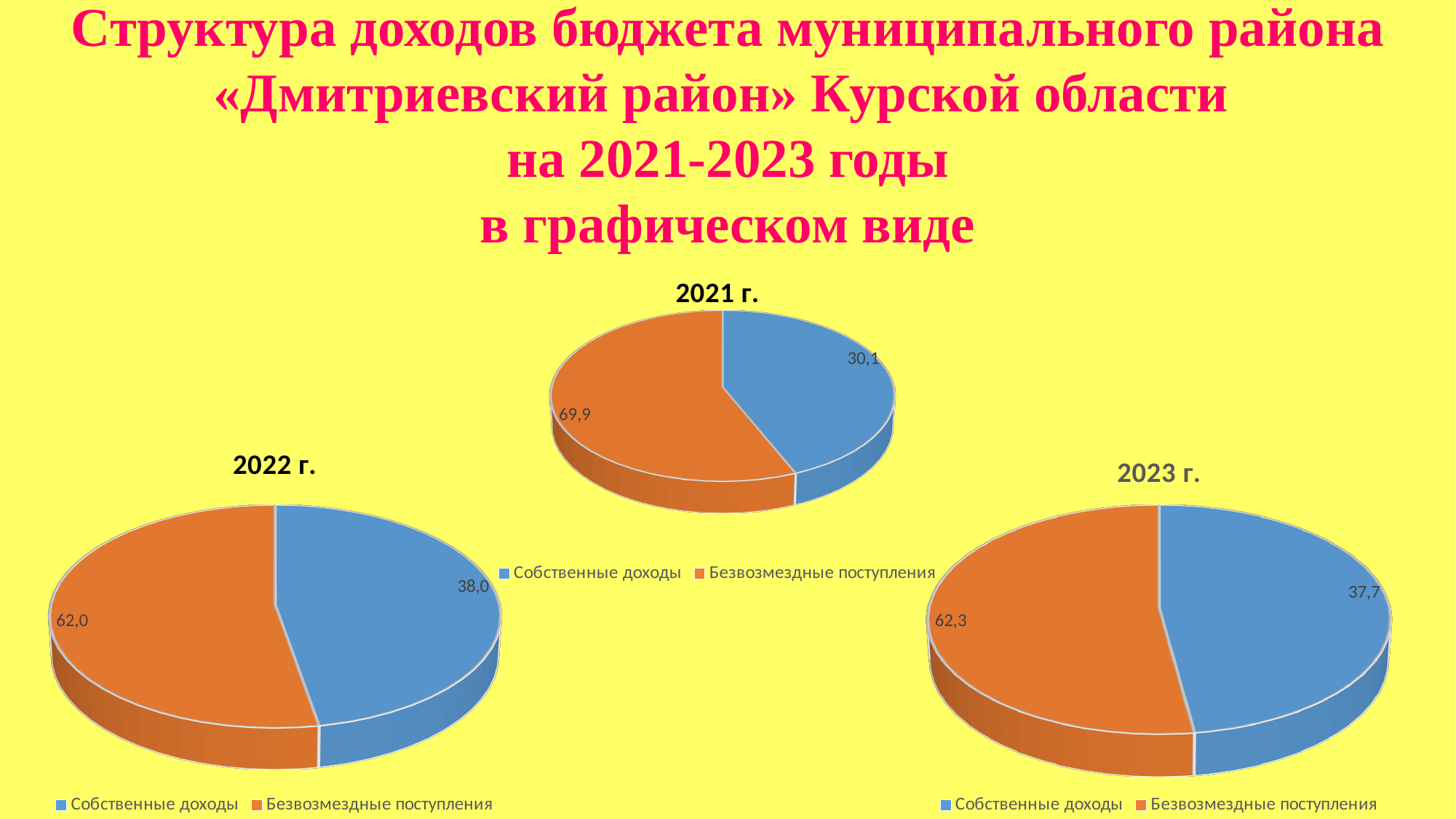
How many slices does the chart titled "2023 г." have? 2 In the chart titled "2021 г.", what is the difference between Безвозмездные поступления and Собственные доходы? 39,8 In the chart titled "2022 г.", what is the difference between Безвозмездные поступления and Собственные доходы? 24,0 What kind of chart is the chart titled "2021 г."? Pie chart In the chart titled "2022 г.", what colour is the slice for Собственные доходы? Blue In the chart titled "2023 г.", which category has the smallest slice? Собственные доходы Which is larger: Собственные доходы in the chart titled "2022 г." or Собственные доходы in the chart titled "2023 г."? 2022 г. In the chart titled "2022 г.", what is the value for Собственные доходы? 38,0 In the chart titled "2021 г.", what is the value for Собственные доходы? 30,1 In the chart titled "2021 г.", what is the value for Безвозмездные поступления? 69,9 In the chart titled "2023 г.", what is the value for Безвозмездные поступления? 62,3 In the chart titled "2022 г.", which category has the largest slice? Безвозмездные поступления